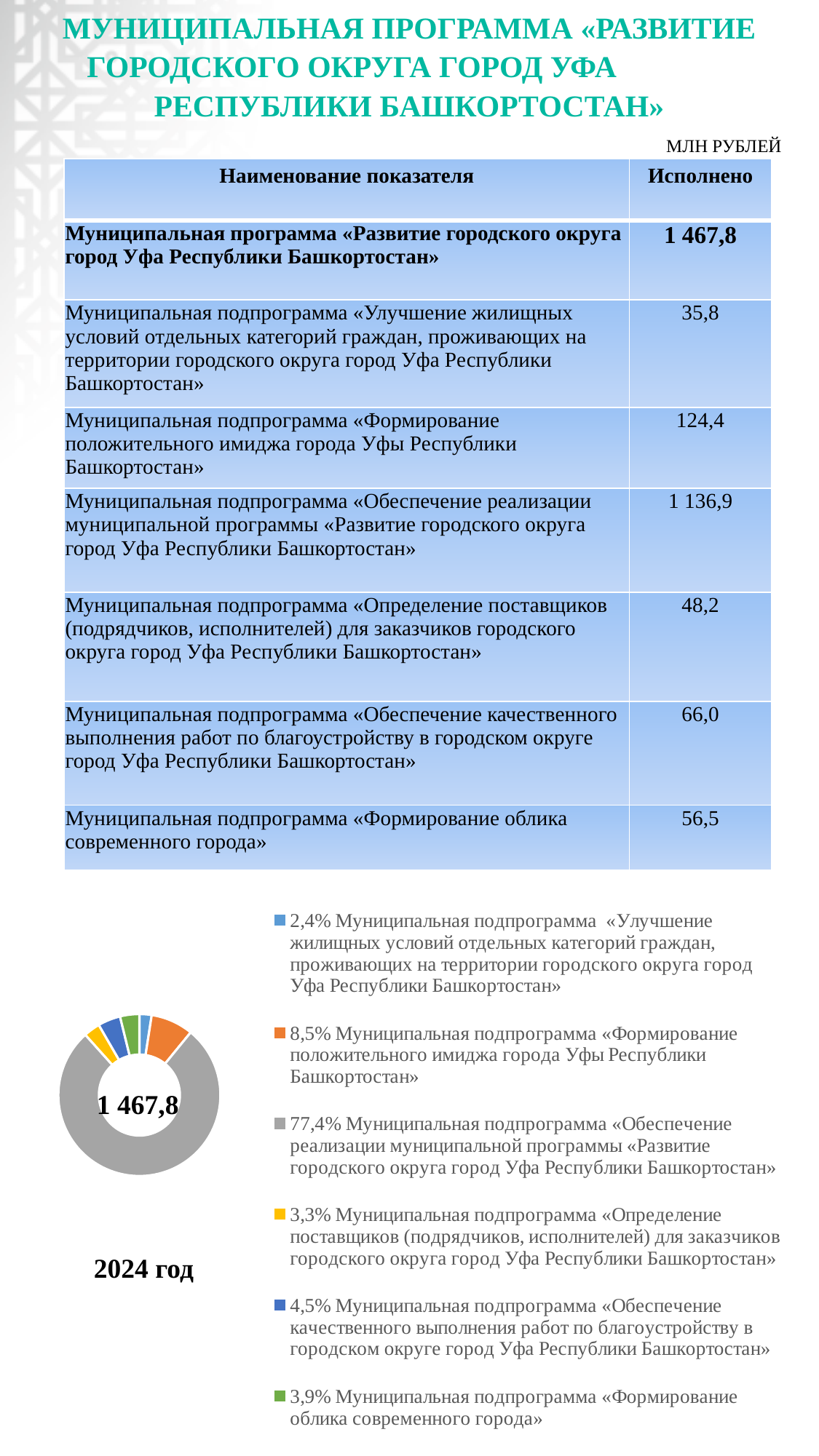
What share of the donut chart does the subprogramme «Формирование положительного имиджа города Уфы Республики Башкортостан» hold? 8,5% Which year is the donut chart labelled with? 2024 год Which subprogramme has the largest slice in the donut chart? Муниципальная подпрограмма «Обеспечение реализации муниципальной программы «Развитие городского округа город Уфа Республики Башкортостан» What share of the donut chart does the subprogramme «Формирование облика современного города» hold? 3,9% What share of the donut chart does the subprogramme «Обеспечение реализации муниципальной программы «Развитие городского округа город Уфа Республики Башкортостан» hold? 77,4% Which slice is larger in the donut chart: «Обеспечение качественного выполнения работ по благоустройству...» or «Определение поставщиков (подрядчиков, исполнителей)...»? «Обеспечение качественного выполнения работ по благоустройству...» (4,5%) What kind of chart is shown at the bottom of the slide? Pie (donut) chart What colour is the largest slice of the donut chart? Grey What total value is printed in the centre of the donut chart? 1 467,8 How many slices does the donut chart have? 6 Which subprogramme has the smallest slice in the donut chart? Муниципальная подпрограмма «Улучшение жилищных условий отдельных категорий граждан, проживающих на территории городского округа город Уфа Республики Башкортостан» What is the difference in share between the «Формирование положительного имиджа города Уфы» slice and the «Улучшение жилищных условий» slice? 6,1%